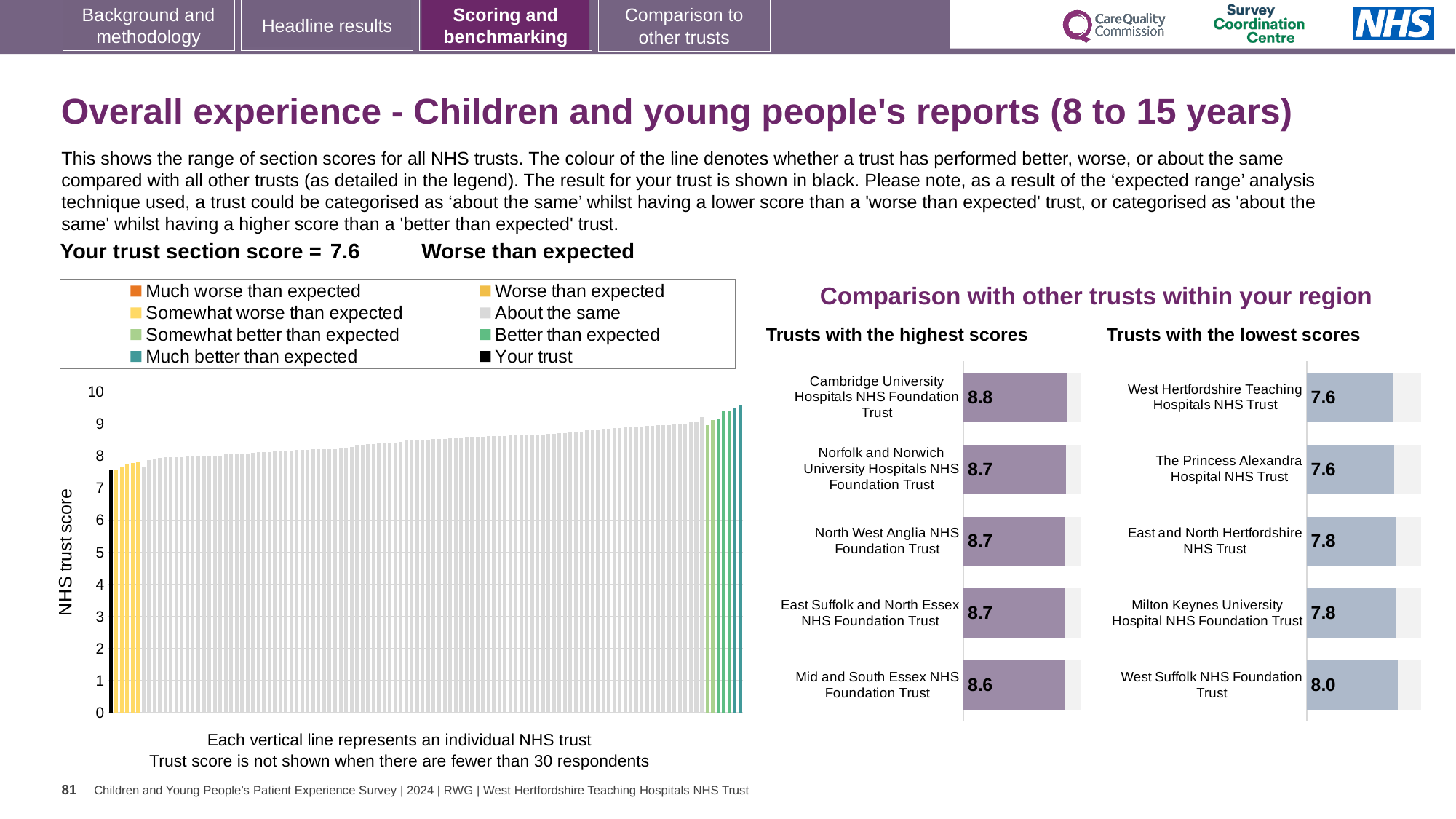
In the 'Trusts with the highest scores' chart, how many trusts are shown? 5 In the 'Trusts with the lowest scores' chart, which trust has the highest score? West Suffolk NHS Foundation Trust In the 'Trusts with the highest scores' chart, which trust has the lowest score? Mid and South Essex NHS Foundation Trust In the 'Trusts with the lowest scores' chart, what is the score for East and North Hertfordshire NHS Trust? 7.8 In the 'Trusts with the highest scores' chart, what is the difference between the scores of Cambridge University Hospitals NHS Foundation Trust and Mid and South Essex NHS Foundation Trust? 0.2 In the large chart on the left showing the range of section scores, how many entries does the legend list? 8 In the 'Trusts with the highest scores' chart, what is the score for Cambridge University Hospitals NHS Foundation Trust? 8.8 In the 'Trusts with the lowest scores' chart, which has the larger score: West Suffolk NHS Foundation Trust or Milton Keynes University Hospital NHS Foundation Trust? West Suffolk NHS Foundation Trust In the large chart on the left showing the range of section scores, do the values rise or fall from left to right along the x axis? Rise In the 'Trusts with the lowest scores' chart, what is the difference between the scores of West Suffolk NHS Foundation Trust and West Hertfordshire Teaching Hospitals NHS Trust? 0.4 In the 'Trusts with the lowest scores' chart, what is the score for West Suffolk NHS Foundation Trust? 8.0 In the large chart on the left showing the range of section scores, what kind of chart is it? Bar chart